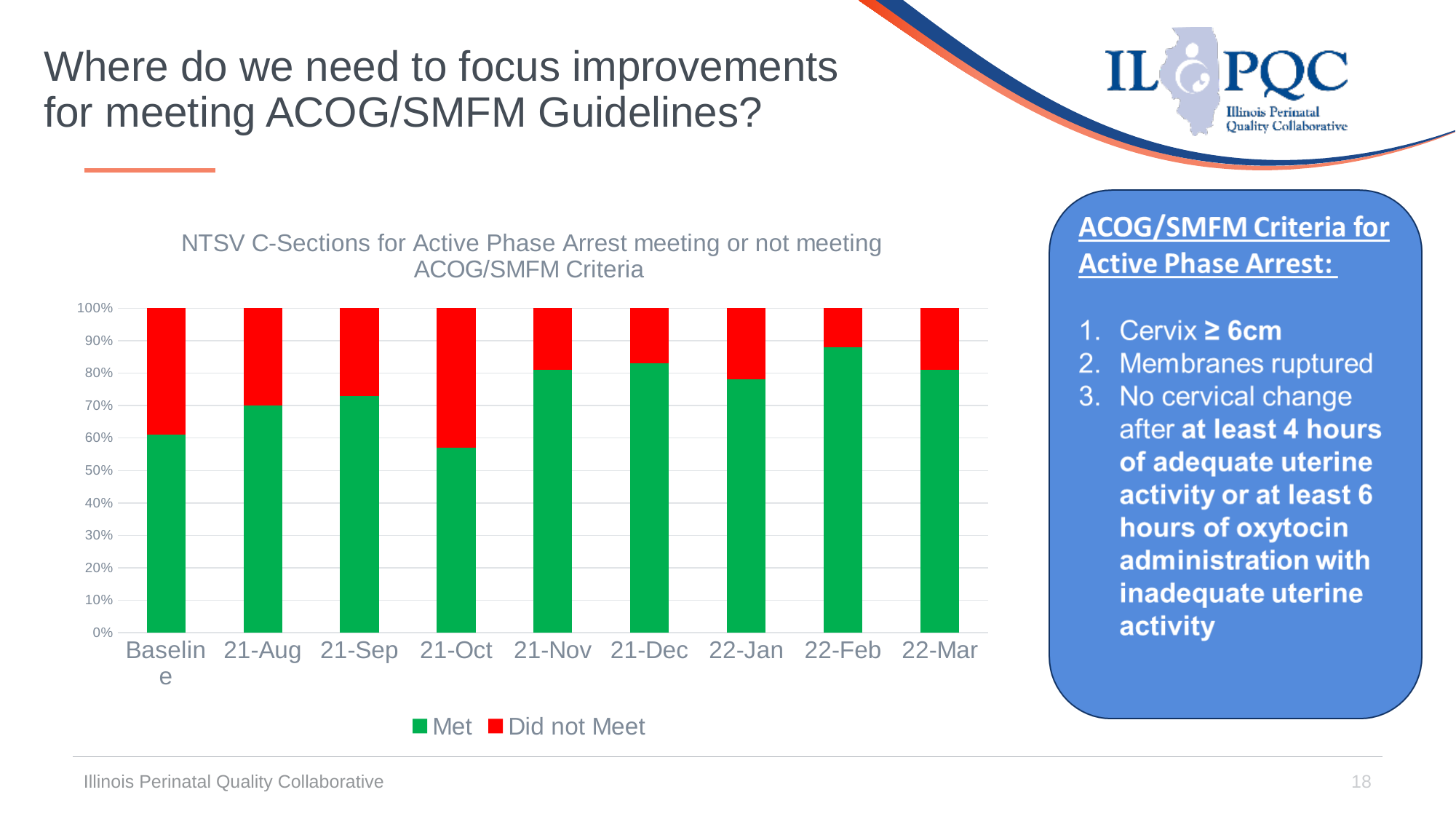
Which period has a larger Met share, Baseline or 21-Nov? 21-Nov Which period has the lowest share of Met? 21-Oct How many series does the chart legend list? 2 Which period has the highest share of Met? 22-Feb What is the total height of each stacked bar in the chart? 100% Is the Met share for 22-Feb greater or less than 80%? greater Which period has a larger Did not Meet share, 21-Oct or 22-Feb? 21-Oct Is the Met share for 21-Oct greater or less than 60%? less What are the two series named in the chart legend? Met and Did not Meet What kind of chart is shown on the slide? Stacked bar chart How many time periods (categories) are shown on the x axis of the chart? 9 Is the Met share for Baseline greater or less than 70%? less